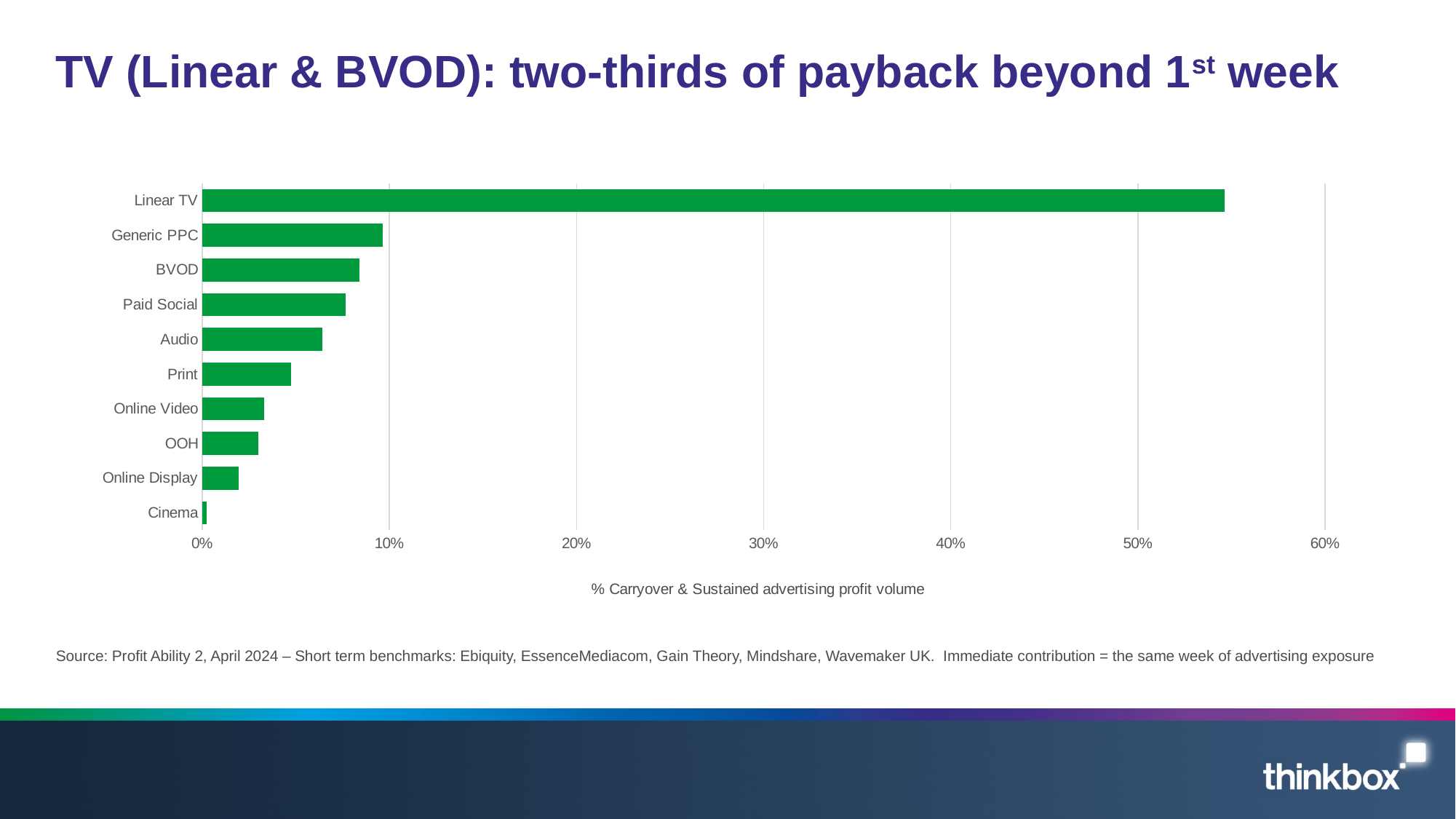
What is the label on the horizontal axis of the chart? % Carryover & Sustained advertising profit volume Which is larger, the value for Audio or the value for Online Display? Audio Which category has the highest % Carryover & Sustained advertising profit volume? Linear TV What kind of chart is shown on the slide? bar chart Is the value for Print greater or less than 10%? less How many categories are plotted in the chart? 10 Which is larger, the value for Linear TV or the value for Generic PPC? Linear TV Is the value for Linear TV greater or less than 50%? greater Which is larger, the value for BVOD or the value for Print? BVOD Is the value for Linear TV greater or less than 60%? less Which category has the lowest % Carryover & Sustained advertising profit volume? Cinema